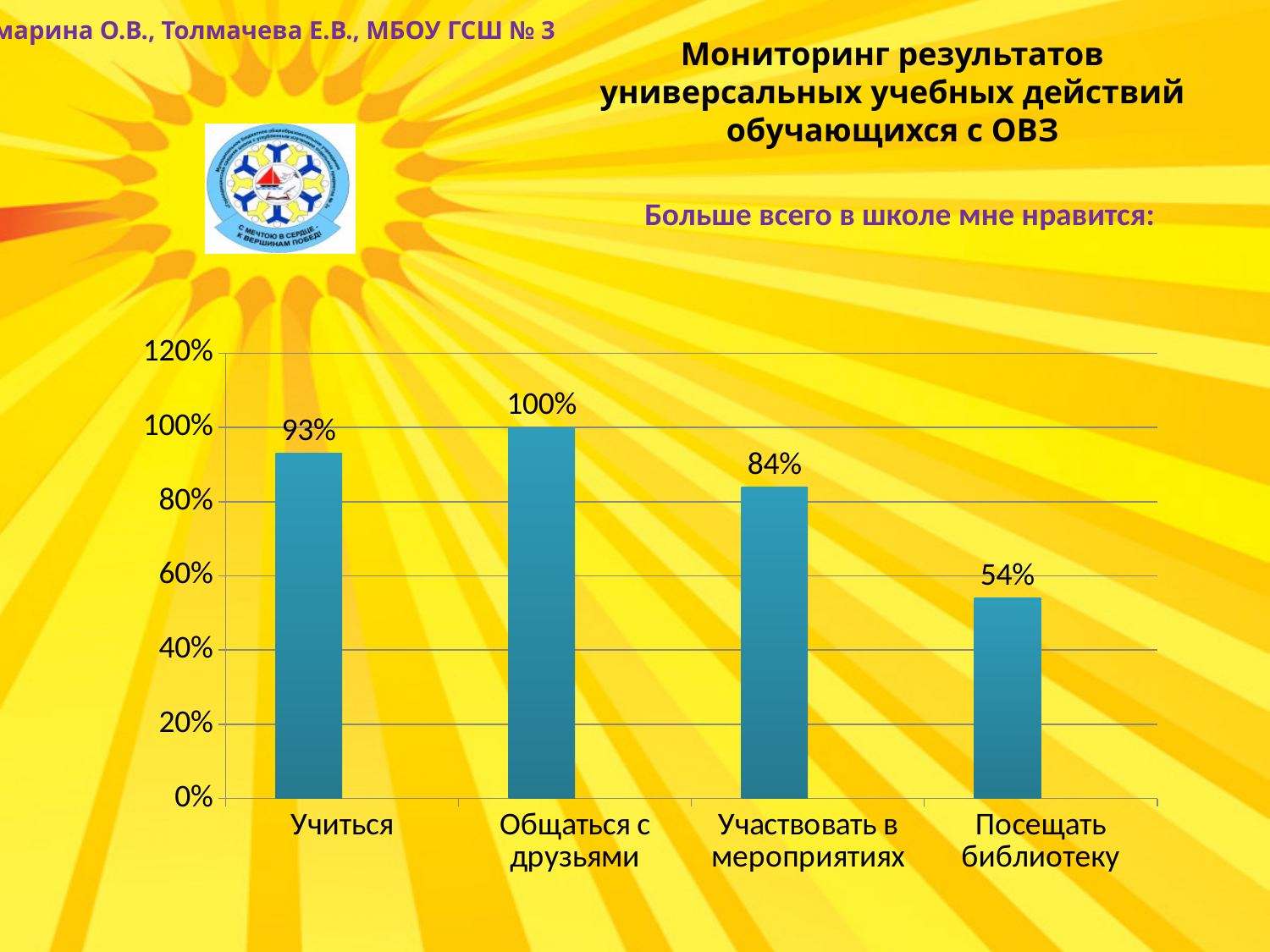
What is the difference between the values for Учиться and Посещать библиотеку? 39% Which category has the highest value? Общаться с друзьями What is the value for Участвовать в мероприятиях? 84% Which category has the lowest value? Посещать библиотеку What is the value for Посещать библиотеку? 54% How many categories are shown on the chart? 4 What is the value for Учиться? 93% What kind of chart is shown on the slide? Bar chart Which is larger, the value for Учиться or the value for Участвовать в мероприятиях? Учиться What is the difference between the values for Общаться с друзьями and Участвовать в мероприятиях? 16% What is the heading shown above the chart? Больше всего в школе мне нравится: What is the value for Общаться с друзьями? 100%